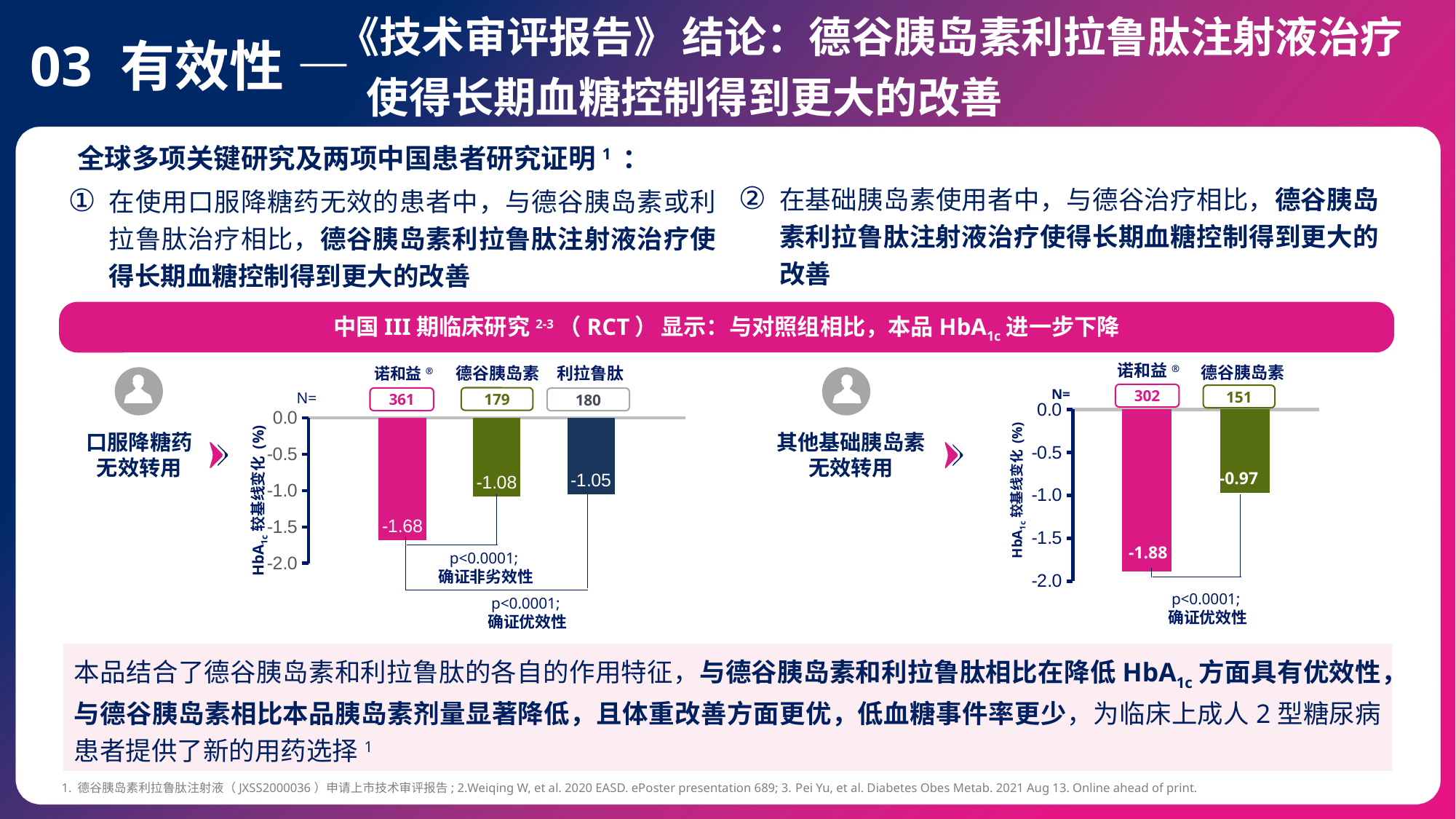
In the right chart (其他基础胰岛素无效转用), by how many percentage points does the HbA1c reduction for 诺和益 exceed that for 德谷胰岛素? 0.91 In the left chart (口服降糖药无效转用), what is the HbA1c change from baseline for 诺和益? -1.68 In the left chart (口服降糖药无效转用), by how many percentage points does the HbA1c reduction for 诺和益 exceed that for 德谷胰岛素? 0.60 In the left chart (口服降糖药无效转用), which group shows the largest reduction in HbA1c? 诺和益 How many bars are plotted in the left chart (口服降糖药无效转用)? 3 In the right chart (其他基础胰岛素无效转用), what is the HbA1c change from baseline for 德谷胰岛素? -0.97 In the left chart (口服降糖药无效转用), what is the N value shown for 诺和益? 361 In the left chart (口服降糖药无效转用), what is the HbA1c change from baseline for 利拉鲁肽? -1.05 In the right chart (其他基础胰岛素无效转用), what is the HbA1c change from baseline for 诺和益? -1.88 In the right chart (其他基础胰岛素无效转用), which group shows the smallest reduction in HbA1c? 德谷胰岛素 In the left chart (口服降糖药无效转用), what is the HbA1c change from baseline for 德谷胰岛素? -1.08 What type of chart is used on the right (其他基础胰岛素无效转用)? Bar chart